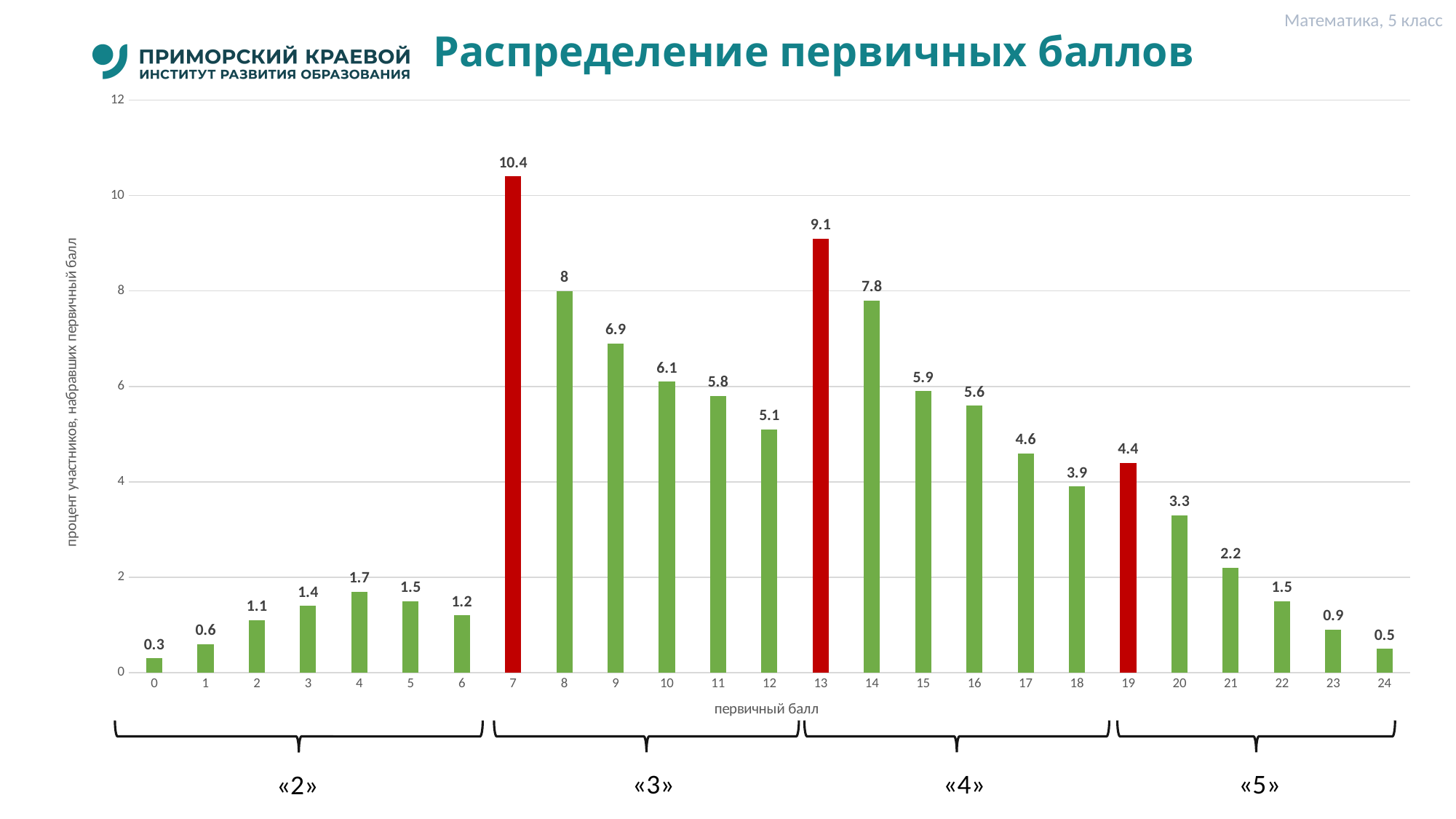
What is the difference between the values for primary scores 7 and 13? 1.3 Which primary scores are shown with red bars? 7, 13 and 19 Which has a larger value: primary score 9 or primary score 15? 9 What is the value for a primary score of 0? 0.3 What is the value for a primary score of 14? 7.8 What is the percentage of participants who scored 7 primary points? 10.4 Is the value for primary score 8 greater or less than 6? greater Do the values rise or fall from primary score 13 to primary score 18? fall What type of chart is shown on the slide? bar chart How many primary score categories are shown on the x axis? 25 Which primary score has the lowest percentage of participants? 0 Which primary score has the highest percentage of participants? 7